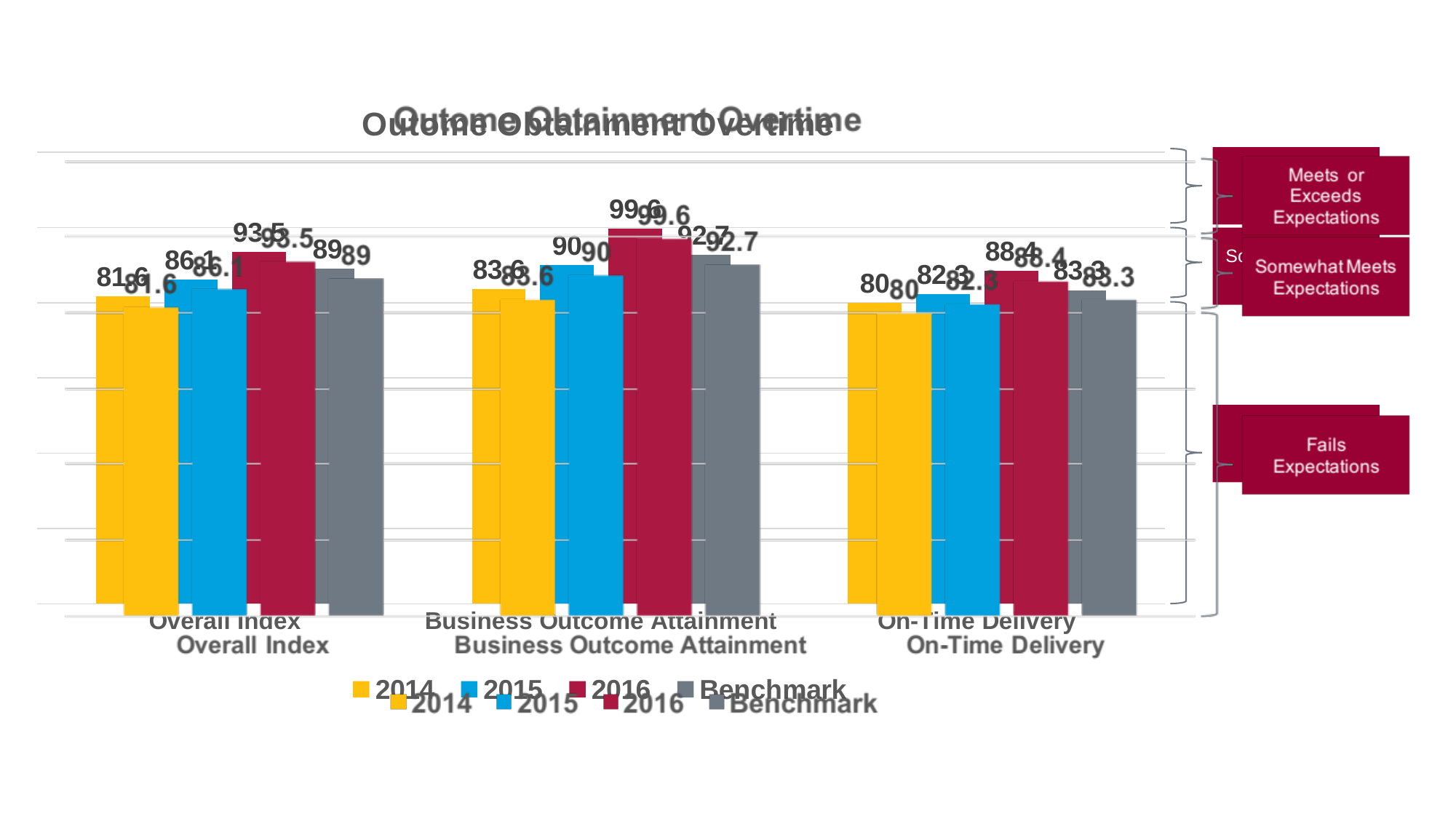
Which is larger for On-Time Delivery, the 2016 value or the Benchmark value? 2016 What is the 2016 value for Business Outcome Attainment? 99.6 What is the 2015 value for Business Outcome Attainment? 90 What is the 2014 value for On-Time Delivery? 80 Which category has the lowest 2014 value? On-Time Delivery What is the title of the chart? Outcome Obtainment Overtime What kind of chart is shown? Bar chart How many series does the legend list? 4 Which category has the highest 2016 value? Business Outcome Attainment What is the Benchmark value for Overall Index? 89 How many categories are shown on the x axis? 3 What is the difference between the 2016 and 2014 values for Overall Index? 11.9